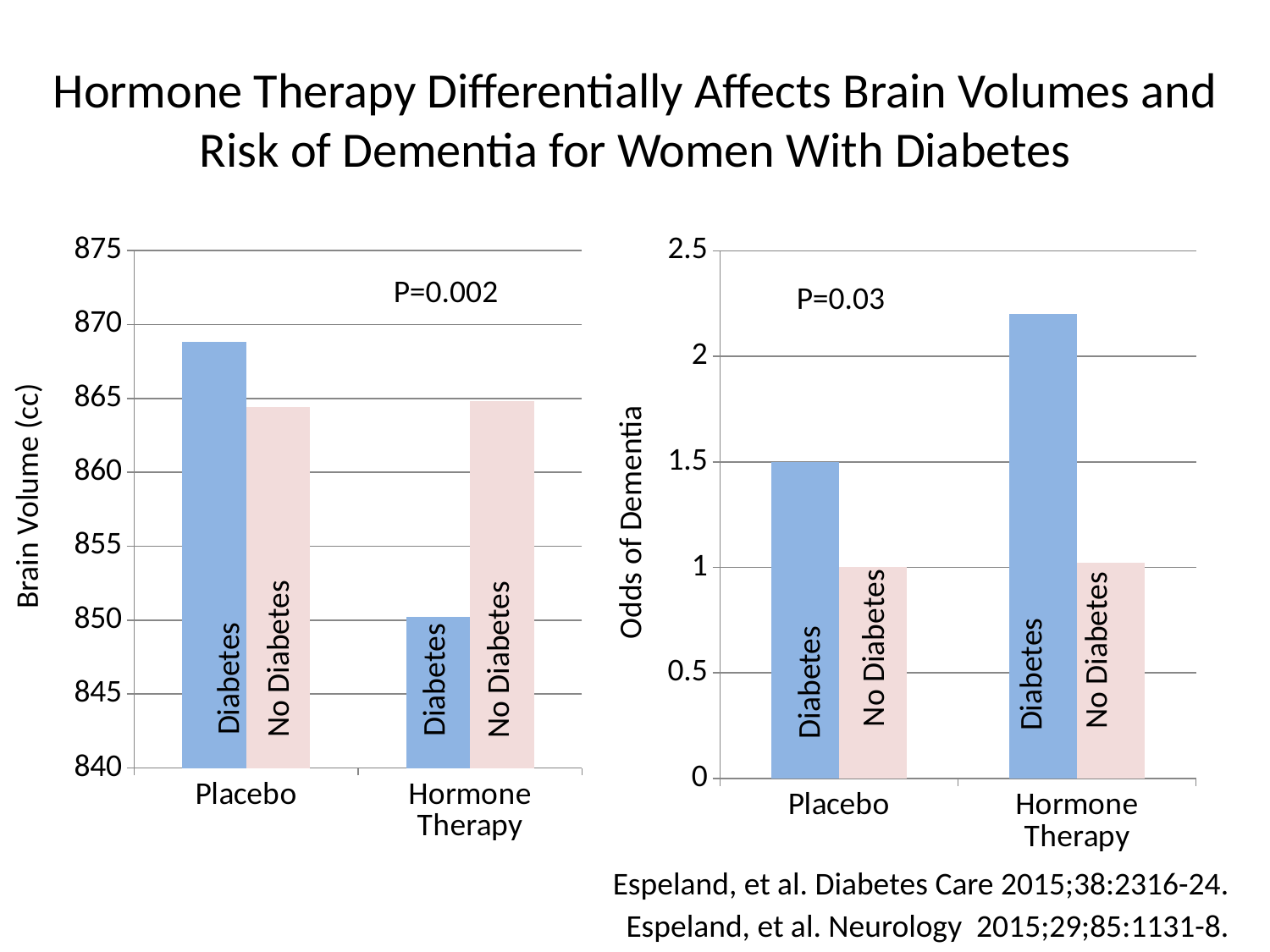
What P value is printed on the left chart (Brain Volume)? P=0.002 In the left chart (Brain Volume), which bar is the highest? Diabetes under Placebo In the right chart (Odds of Dementia), what is the value for Diabetes under Placebo? 1.5 In the left chart (Brain Volume), which is larger under Placebo: Diabetes or No Diabetes? Diabetes In the left chart (Brain Volume), is the value for Diabetes under Hormone Therapy greater or less than 855? less In the right chart (Odds of Dementia), which bar is the highest? Diabetes under Hormone Therapy What kind of chart is the left chart (Brain Volume)? bar chart In the right chart (Odds of Dementia), which is larger under Hormone Therapy: Diabetes or No Diabetes? Diabetes How many treatment categories are shown on the x axis of the right chart (Odds of Dementia)? 2 In the left chart (Brain Volume), is the value for Diabetes under Placebo greater or less than 865? greater In the left chart (Brain Volume), which bar is the lowest? Diabetes under Hormone Therapy In the right chart (Odds of Dementia), is the value for Diabetes under Hormone Therapy greater or less than 2? greater